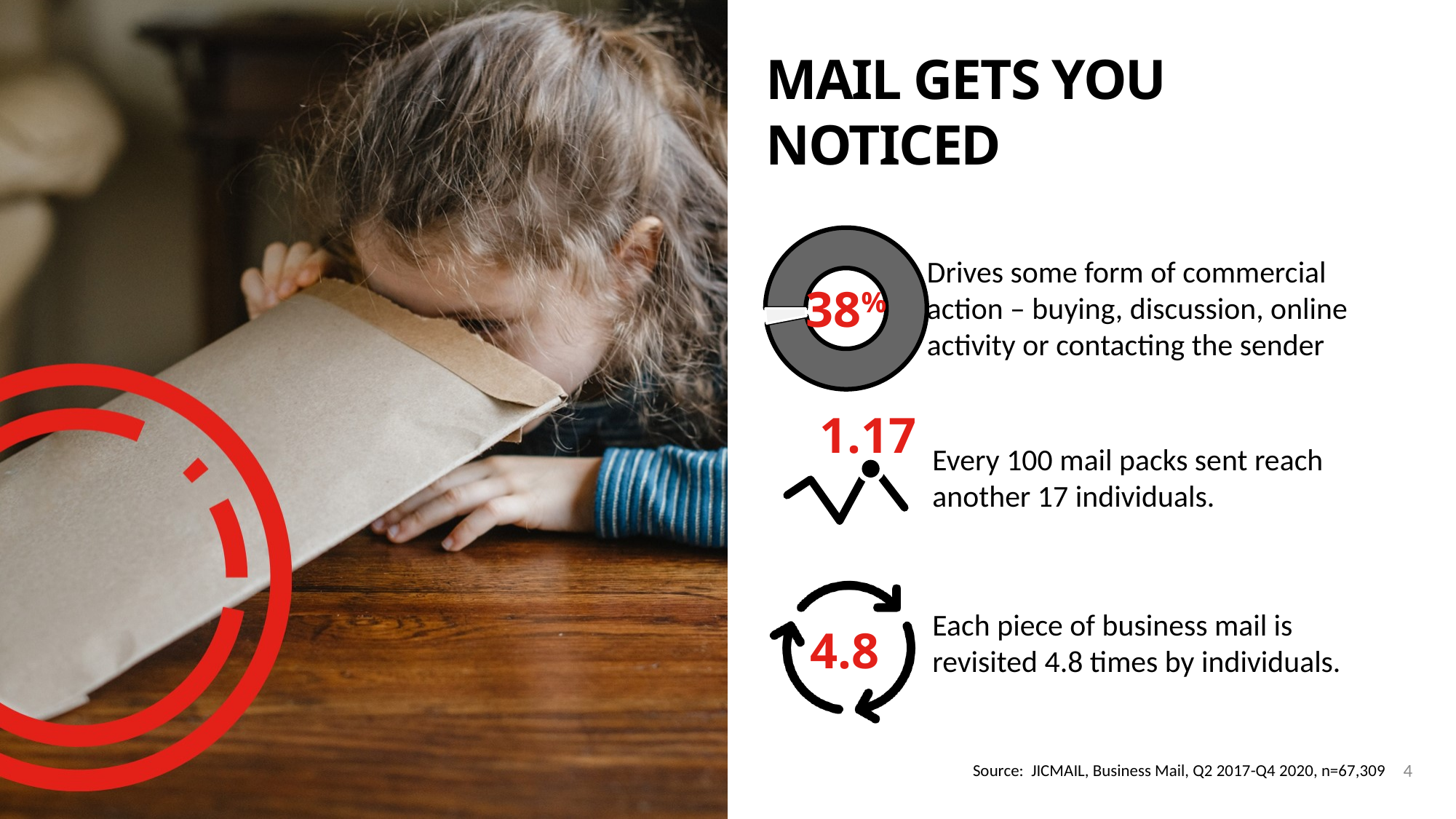
What percentage is shown in the centre of the donut chart? 38% What kind of chart is shown next to the text 'Drives some form of commercial action'? donut (pie) chart What colour is the main ring of the donut chart? grey What colour is the 38% label in the donut chart? red According to the donut chart, what share of business mail drives some form of commercial action? 38%